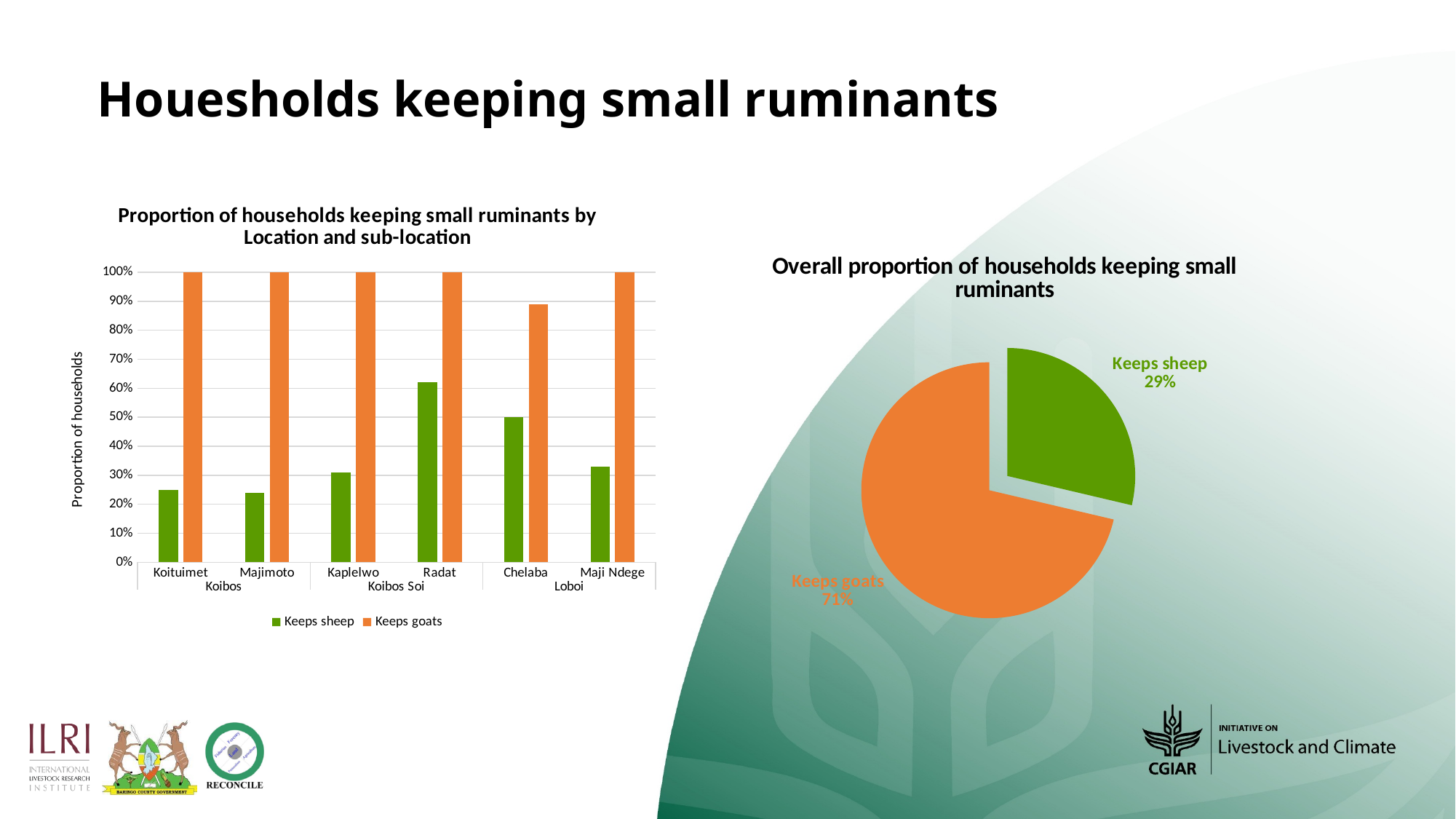
In the pie chart 'Overall proportion of households keeping small ruminants', what share of households keeps sheep? 29% In the bar chart on the left, how many sub-locations are shown on the x axis? 6 In the pie chart 'Overall proportion of households keeping small ruminants', what share of households keeps goats? 71% In the bar chart on the left, how many series does the legend list? 2 In the bar chart on the left, which colour represents the 'Keeps goats' series? Orange In the bar chart on the left, is the 'Keeps goats' value for Chelaba greater or less than 80%? greater What kind of chart is the 'Overall proportion of households keeping small ruminants' chart? Pie chart In the bar chart on the left, is the 'Keeps sheep' value for Radat greater or less than 50%? greater In the pie chart on the right, by how many percentage points does the 'Keeps goats' share exceed the 'Keeps sheep' share? 42 percentage points What kind of chart is the 'Proportion of households keeping small ruminants by Location and sub-location' chart? Bar chart In the bar chart on the left, what is the 'Keeps goats' value for Koituimet? 100% In the bar chart on the left, which sub-location has the highest proportion of households keeping sheep? Radat